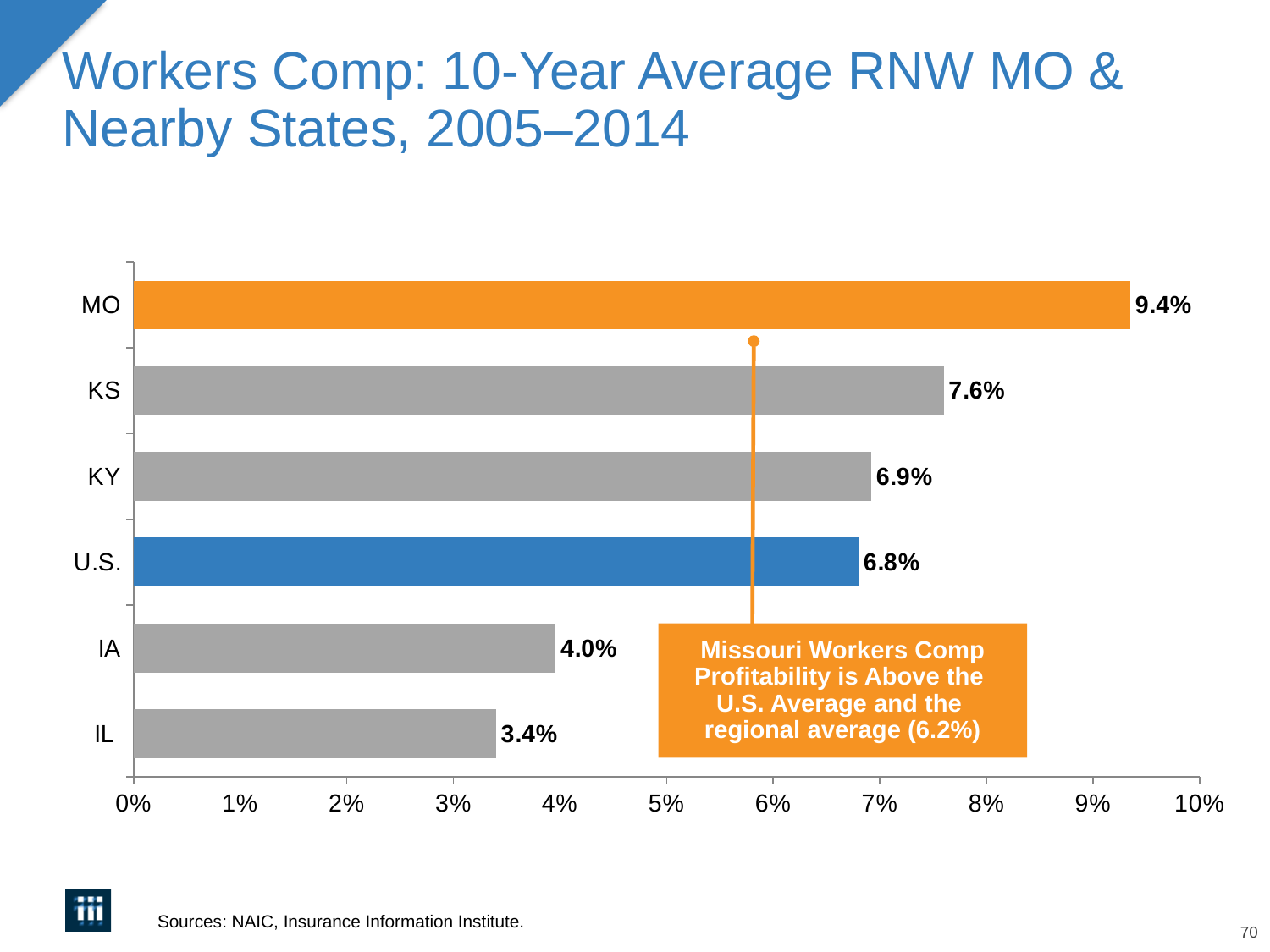
What is the value shown for the U.S.? 6.8% Which category has the lowest value? IL What is the value shown for KS? 7.6% What is the 10-year average RNW for MO? 9.4% What is the difference between the values for MO and the U.S.? 2.6% What regional average is stated in the callout box on the chart? 6.2% What is the value shown for IL? 3.4% Which category has the highest value? MO How many categories are shown in the chart? 6 What is the difference between the values for KS and KY? 0.7% What kind of chart is shown on the slide? Bar chart Which is larger, the value for IA or the value for IL? IA